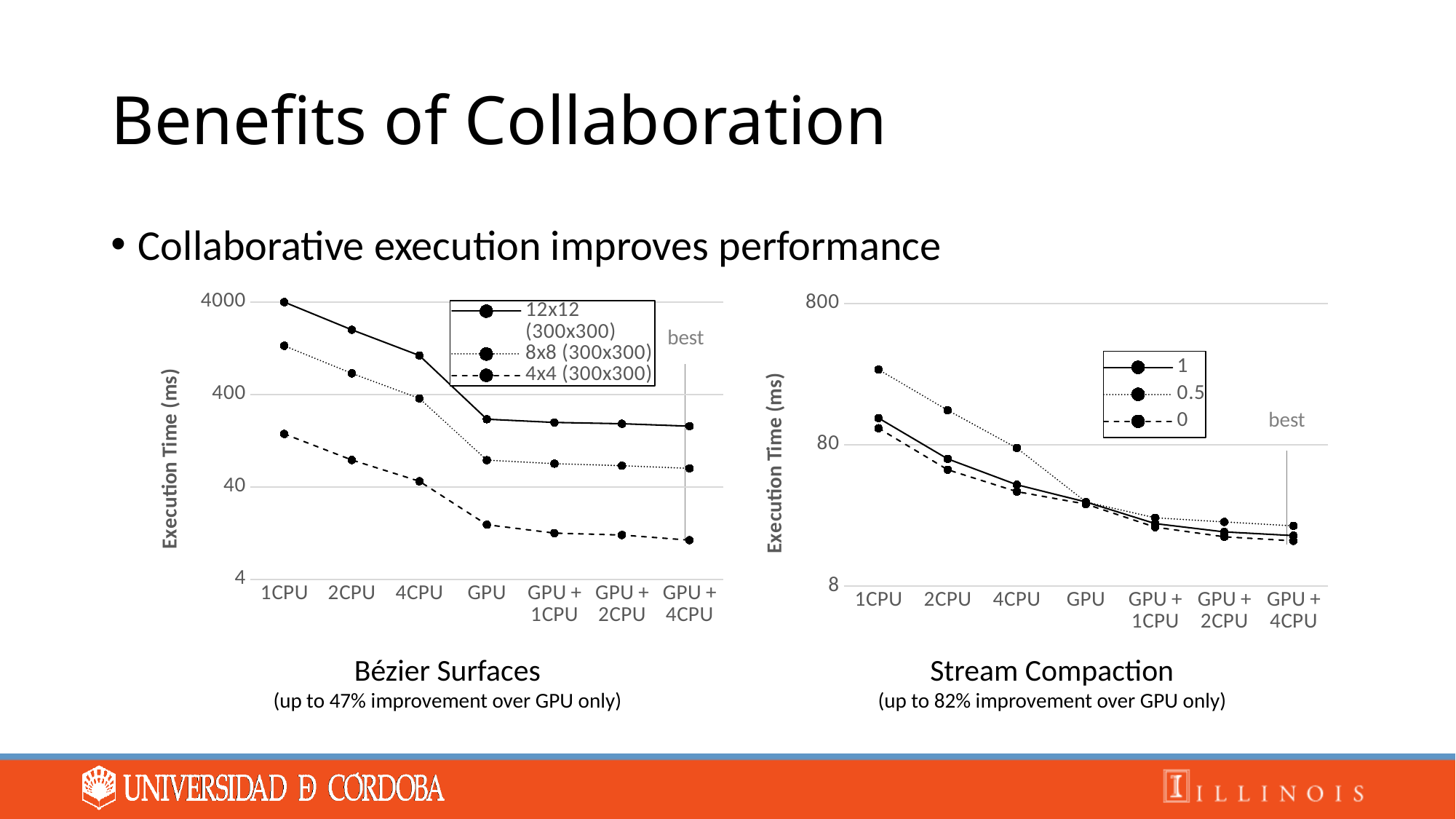
How many series does the legend of the Bézier Surfaces chart list? 3 What kind of chart is the Bézier Surfaces chart on the left? line chart In the Bézier Surfaces chart, is the value for 4x4 (300x300) at GPU greater or less than 40? less In the Stream Compaction chart, at 1CPU, which series has the larger value: 0.5 or 1? 0.5 In the Bézier Surfaces chart, which series has the highest execution time at 1CPU? 12x12 (300x300) In the Stream Compaction chart, is the value for series 0.5 at 1CPU greater or less than 80? greater How many categories are shown on the x axis of the Bézier Surfaces chart? 7 How many series does the legend of the Stream Compaction chart list? 3 In the Bézier Surfaces chart, which series has the lowest execution time at GPU + 4CPU? 4x4 (300x300) In the Stream Compaction chart, is the value for series 0 at GPU + 4CPU greater or less than 80? less In the Bézier Surfaces chart, does the 12x12 (300x300) series rise or fall from 1CPU to GPU + 4CPU? fall